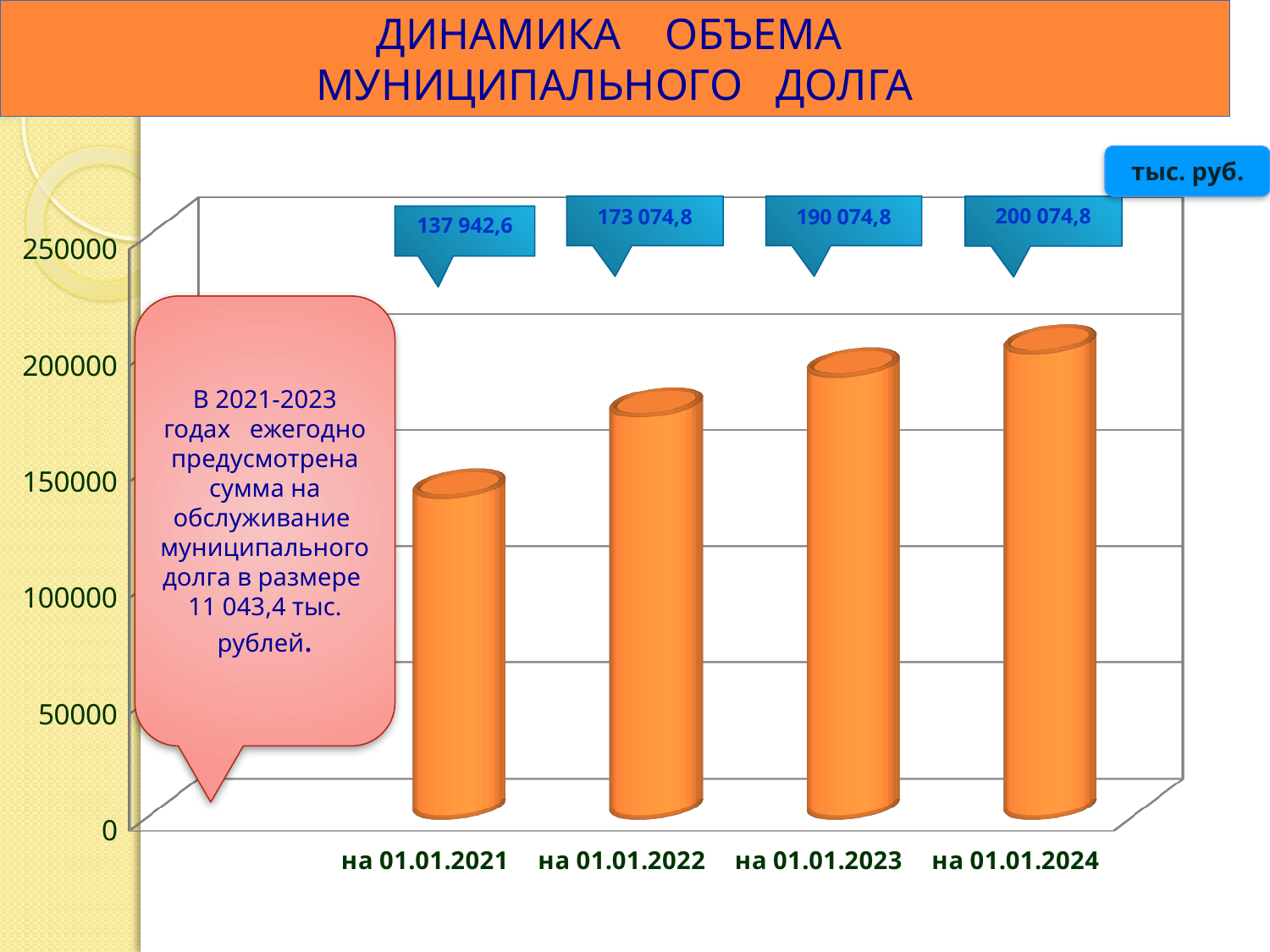
Which date has the highest value? на 01.01.2024 What is the value for на 01.01.2024? 200 074,8 What is the value for на 01.01.2021? 137 942,6 Is the value for на 01.01.2021 greater or less than 150000? less Which date has the lowest value? на 01.01.2021 What is the difference between the values for на 01.01.2023 and на 01.01.2022? 17 000,0 Do the values rise or fall from на 01.01.2021 to на 01.01.2024? rise What is the value for на 01.01.2022? 173 074,8 How many dates are shown on the x axis? 4 What is the difference between the values for на 01.01.2024 and на 01.01.2021? 62 132,2 What kind of chart is shown on the slide? bar chart Which is larger, the value for на 01.01.2022 or the value for на 01.01.2023? на 01.01.2023